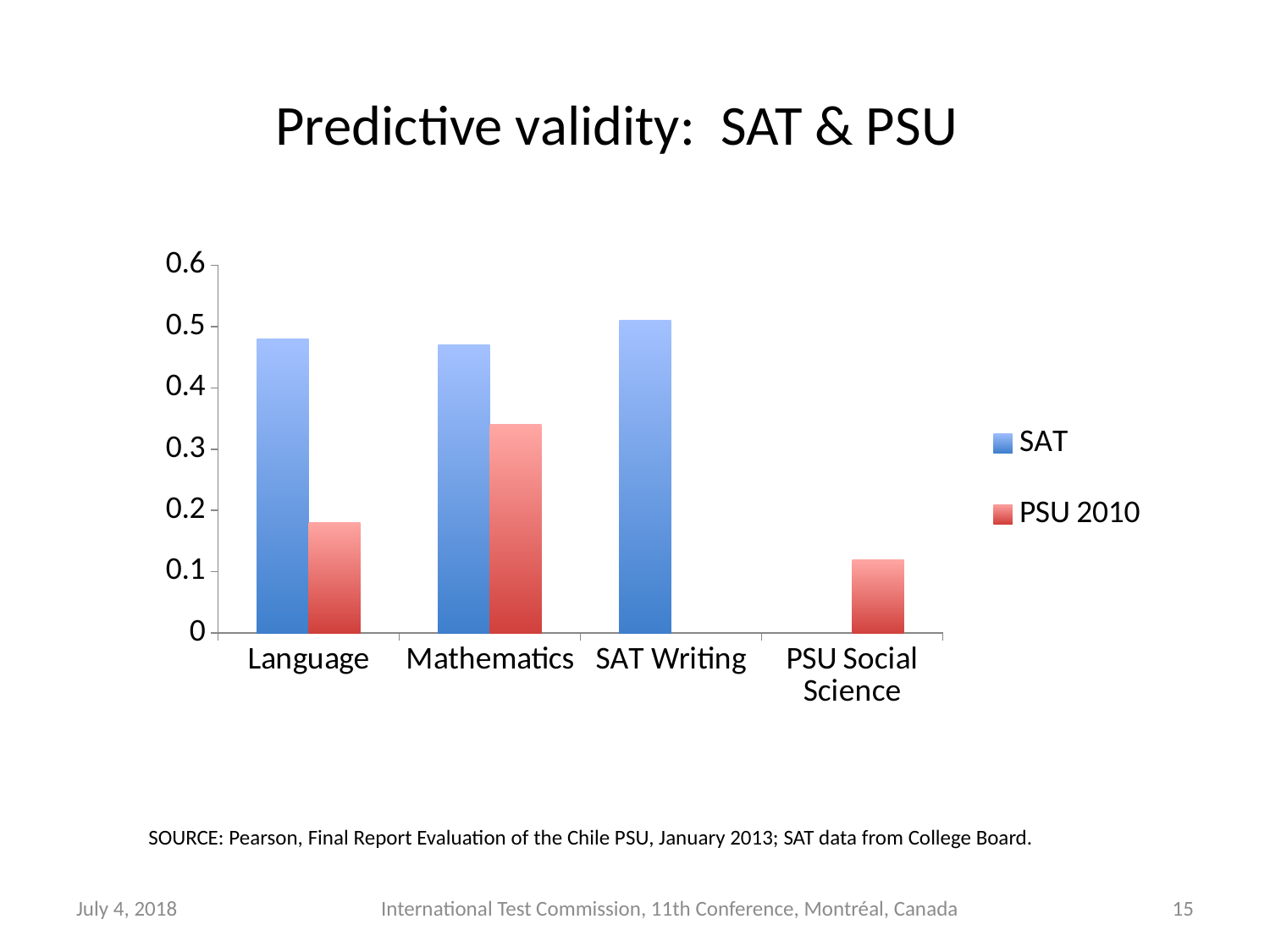
How many series does the legend list? 2 What is the title of the chart? Predictive validity: SAT & PSU Is the SAT value for SAT Writing greater or less than 0.4? greater Which category has the highest PSU 2010 value? Mathematics Which category has the lowest PSU 2010 value? PSU Social Science Is the PSU 2010 value for Language greater or less than 0.2? less What kind of chart is shown on the slide? bar chart For Language, which is larger: the SAT value or the PSU 2010 value? SAT For Mathematics, which is larger: the SAT value or the PSU 2010 value? SAT Is the SAT value for Language greater or less than 0.4? greater How many categories are shown on the x axis? 4